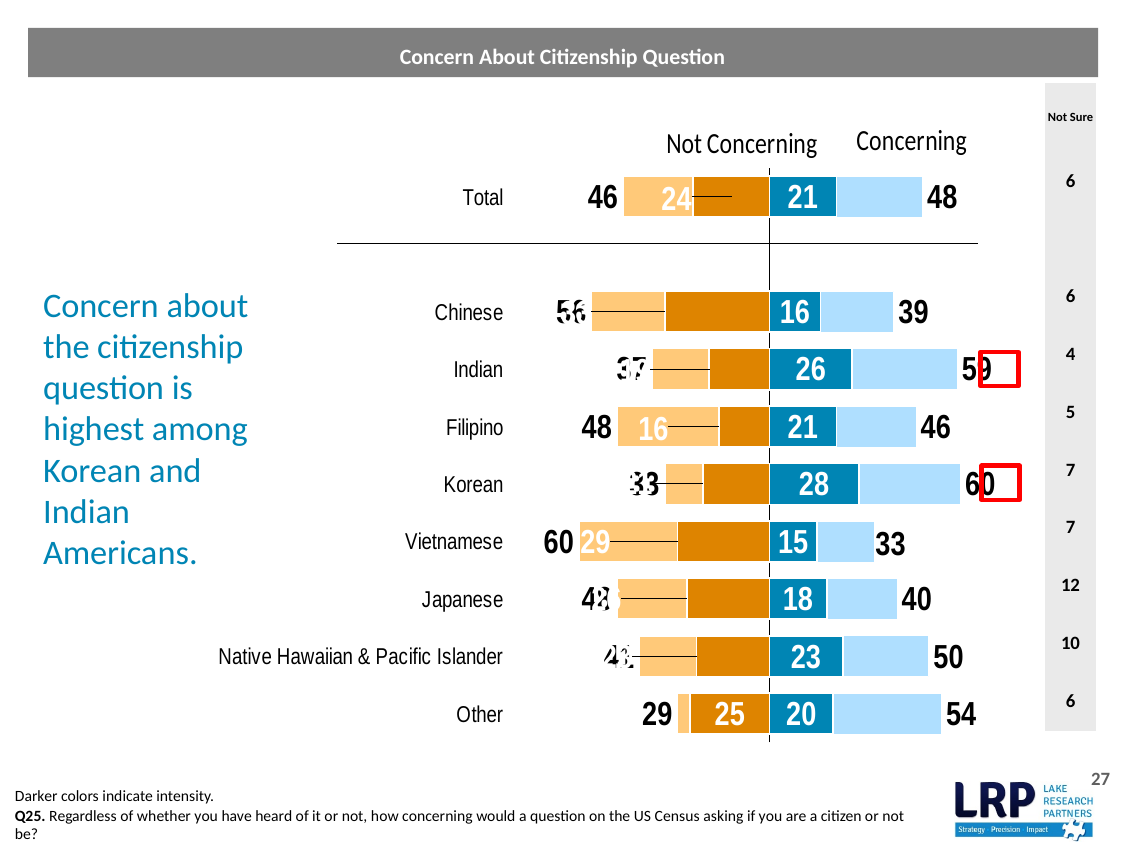
What is the value of the dark blue segment for Indian? 26 Which group has the highest Concerning value? Korean What is the Not Concerning value for Vietnamese? 60 What kind of chart is shown on the slide? Bar chart For Vietnamese, which is larger: the Not Concerning value or the Concerning value? Not Concerning What is the Not Sure value for Japanese? 12 Which group has the lowest Not Sure value? Indian How many groups are shown below the Total row? 8 What is the Concerning value for Korean? 60 Which group has the lowest Concerning value? Vietnamese What is the difference between the Concerning and Not Concerning values for Total? 2 What is the title of the chart? Concern About Citizenship Question